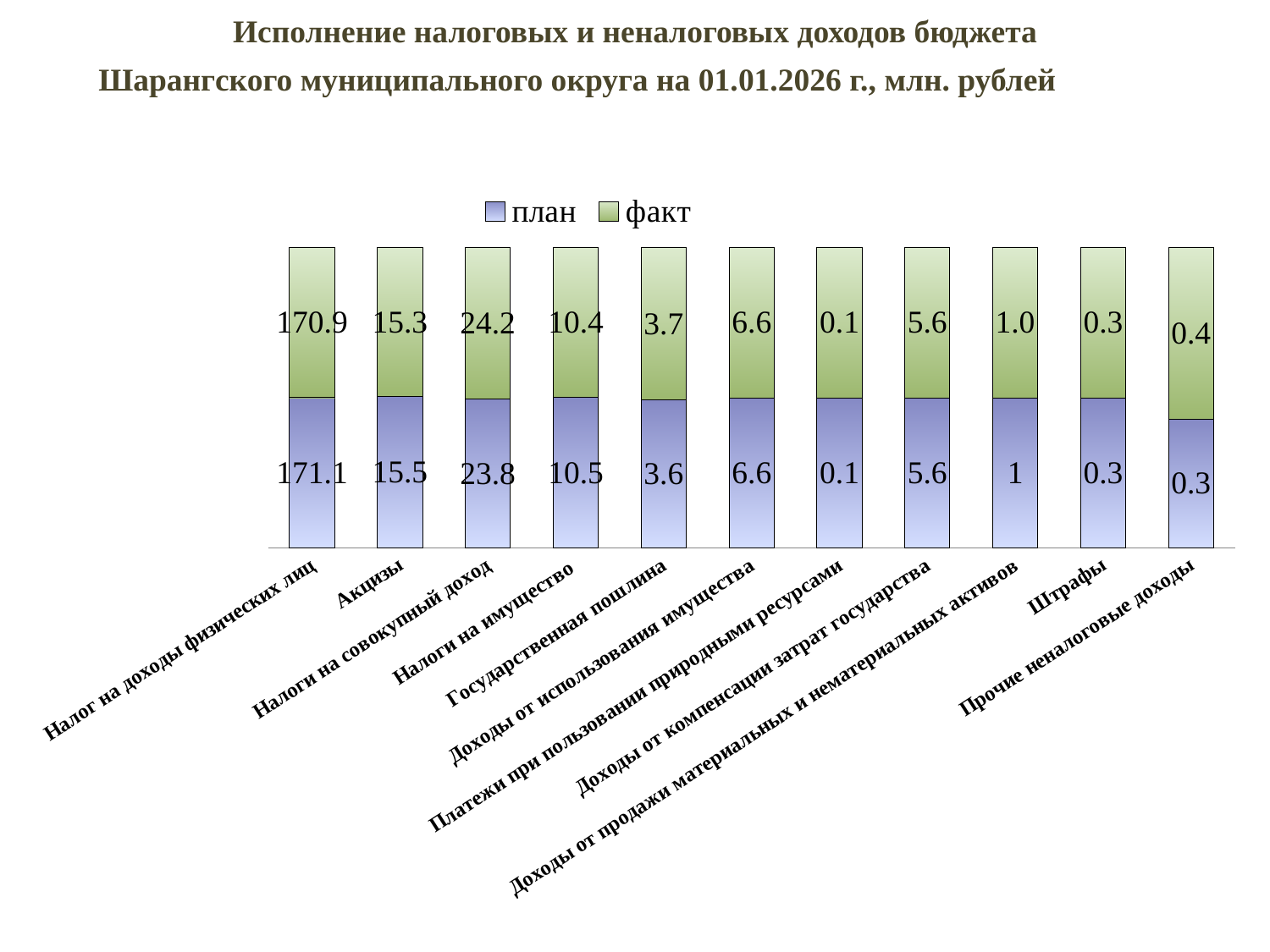
How many series does the legend list? 2 What is the факт value for Налоги на совокупный доход? 24.2 How many categories are shown on the x axis? 11 Which series is shown in green in the legend? факт What kind of chart is shown on the slide? stacked bar chart What is the difference between the план and факт values for Налоги на имущество? 0.1 What is the план value for Прочие неналоговые доходы? 0.3 Which category has the highest факт value? Налог на доходы физических лиц Which category has the lowest план value? Платежи при пользовании природными ресурсами What is the план value for Налог на доходы физических лиц? 171.1 What is the факт value for Акцизы? 15.3 Which is larger for Налоги на совокупный доход, the план value or the факт value? факт